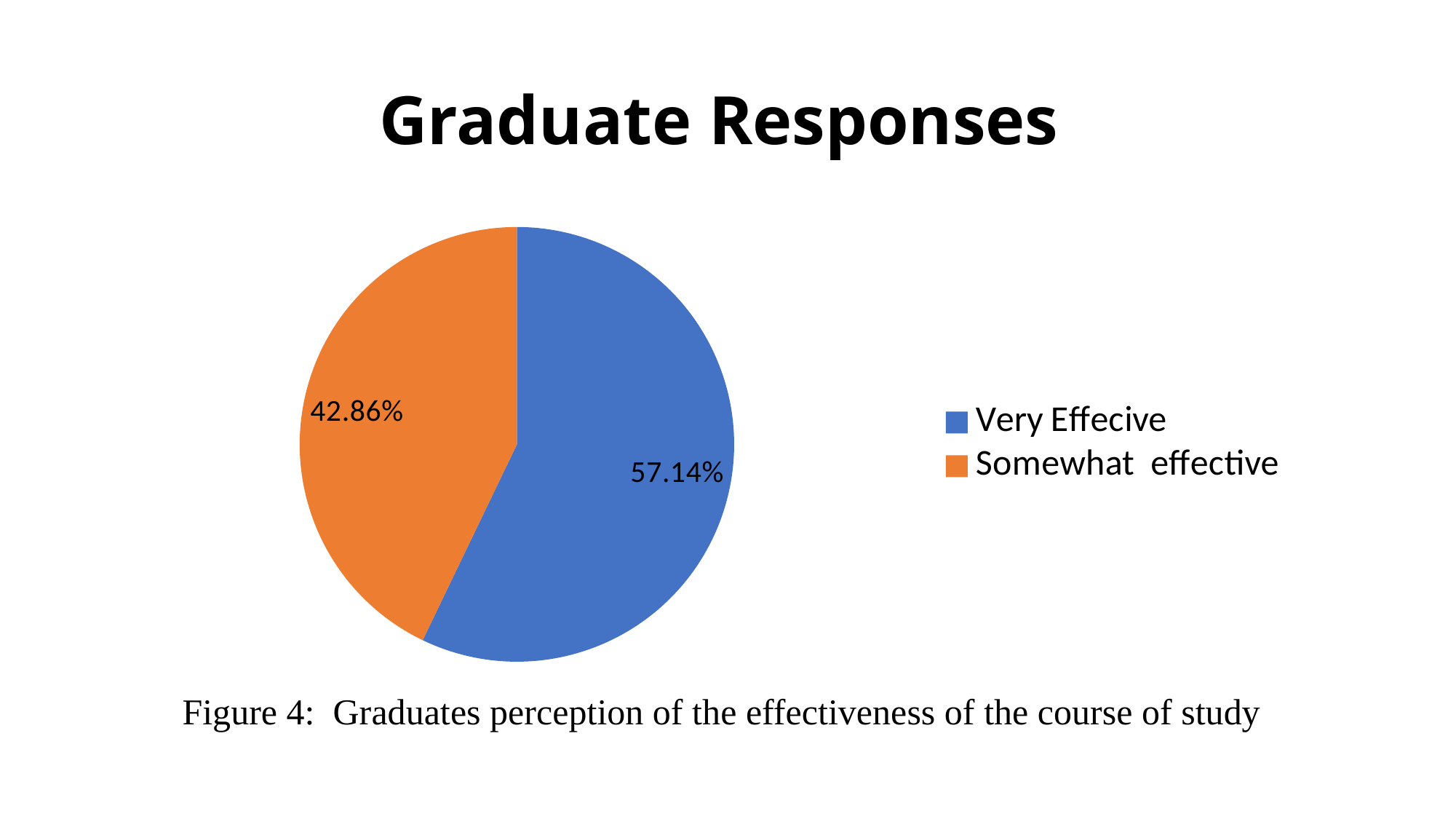
Is the share for "Very Effecive" greater or less than 50%? greater How many entries does the legend list? 2 What colour is the "Somewhat effective" slice? orange Which is larger, the "Very Effecive" slice or the "Somewhat effective" slice? Very Effecive What is the difference in percentage points between the "Very Effecive" and "Somewhat effective" slices? 14.28 What share of graduate responses is labelled "Very Effecive"? 57.14% What is the title shown above the pie chart? Graduate Responses What kind of chart is shown on the slide? pie chart How many slices does the pie chart have? 2 Which slice of the pie is the largest? Very Effecive Which slice of the pie is the smallest? Somewhat effective What share of graduate responses is labelled "Somewhat effective"? 42.86%